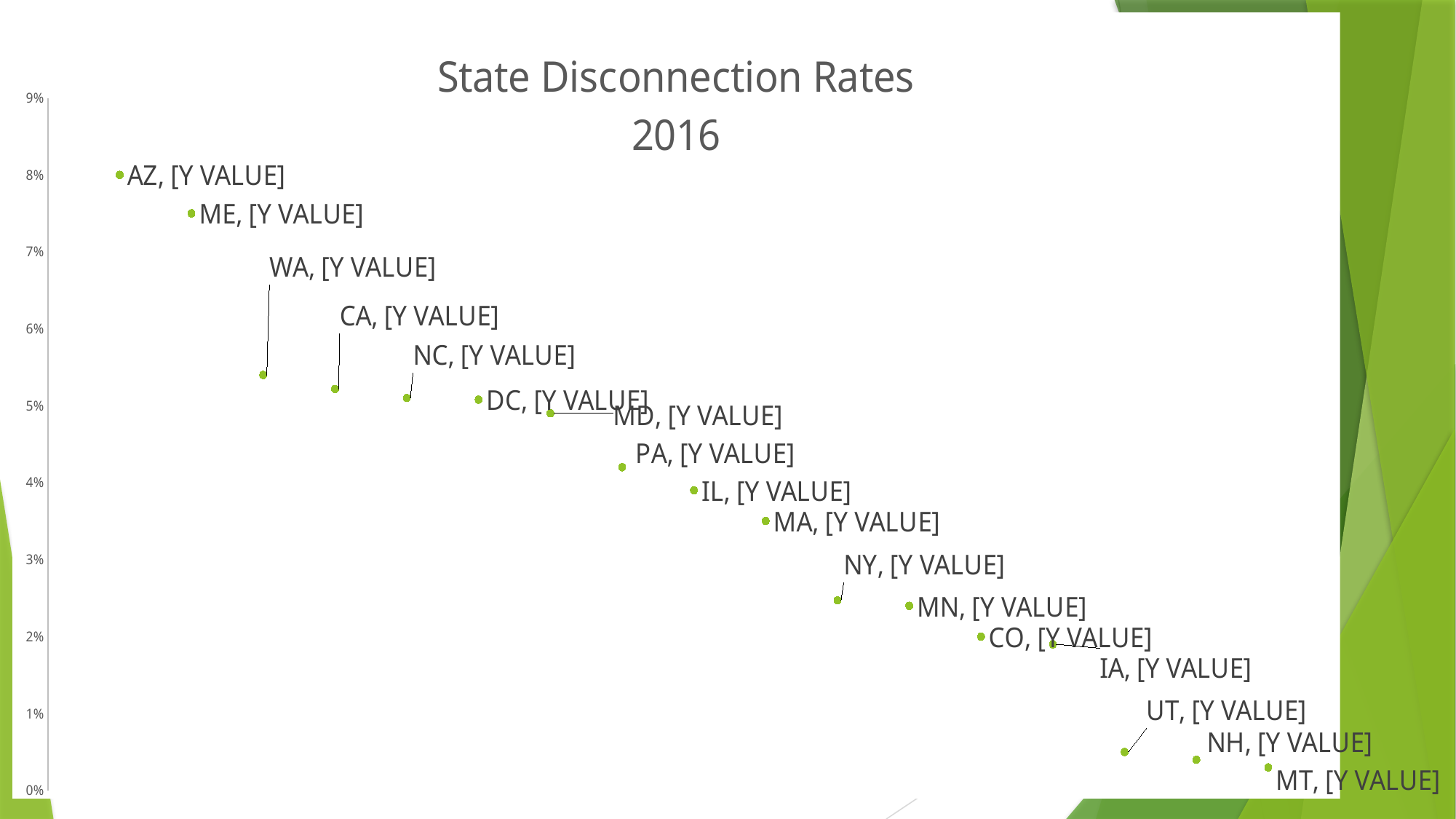
Is the value for WA greater or less than 5%? greater Do the plotted values rise or fall from left to right across the chart? fall Which state has the highest disconnection rate on the chart? AZ Is the value for UT greater or less than 1%? less Which has the larger disconnection rate, WA or NY? WA What kind of chart is shown on the slide? scatter chart How many states are plotted on the chart? 17 Is the value for NY greater or less than 3%? less Which has the larger disconnection rate, MT or ME? ME What is the title of the chart? State Disconnection Rates 2016